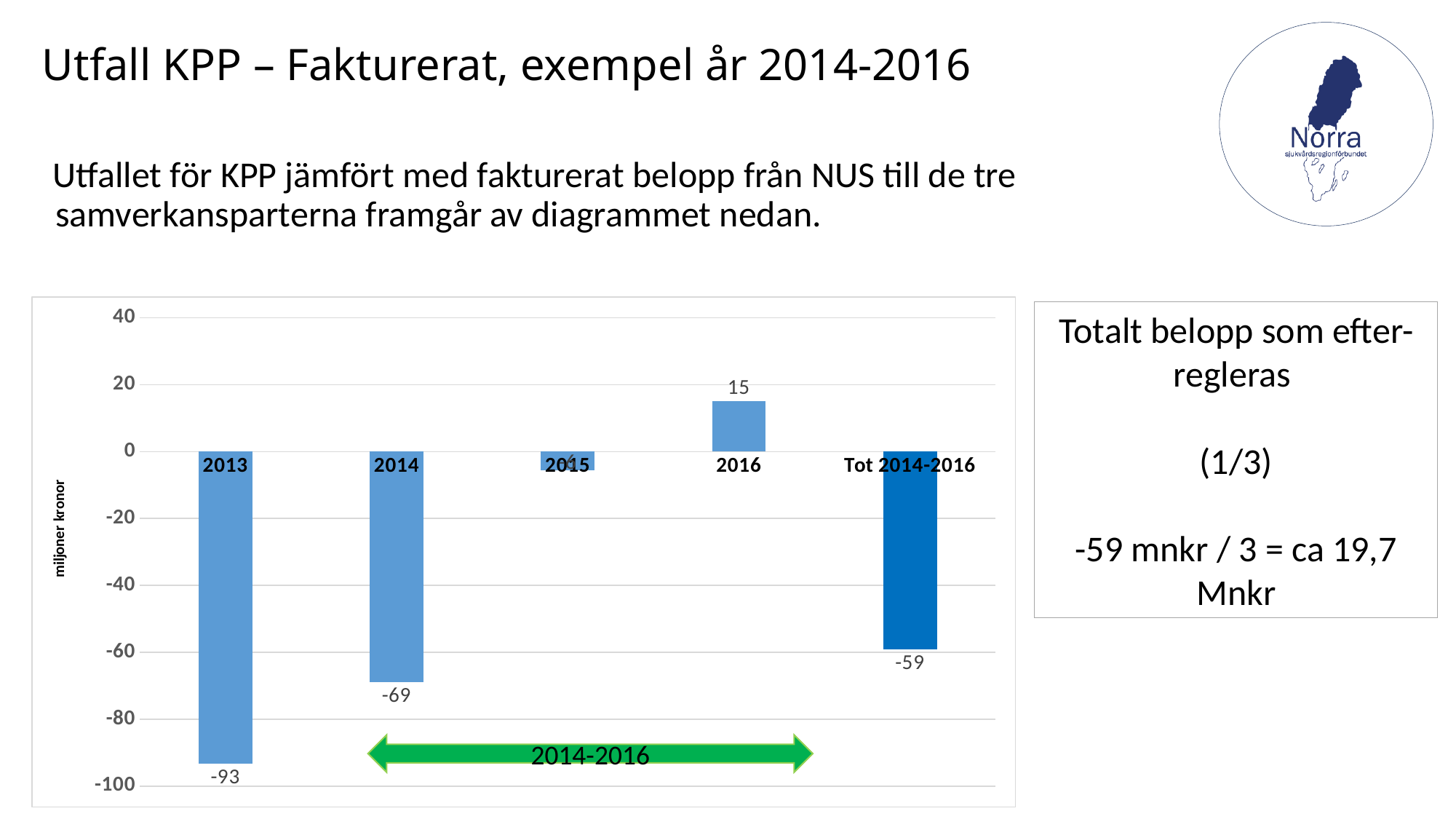
What is the value for Tot 2014-2016? -59 What is the value for 2016? 15 Which category has the highest value? 2016 Which is larger, the value for 2014 or the value for Tot 2014-2016? Tot 2014-2016 What is the value for 2014? -69 What kind of chart is shown? bar chart Which category has the lowest value? 2013 What is the difference between the values for 2014 and 2013? 24 What is the value for 2013? -93 Is the value for 2015 greater or less than -20? greater What is the label on the vertical axis? miljoner kronor How many categories are shown on the x axis? 5